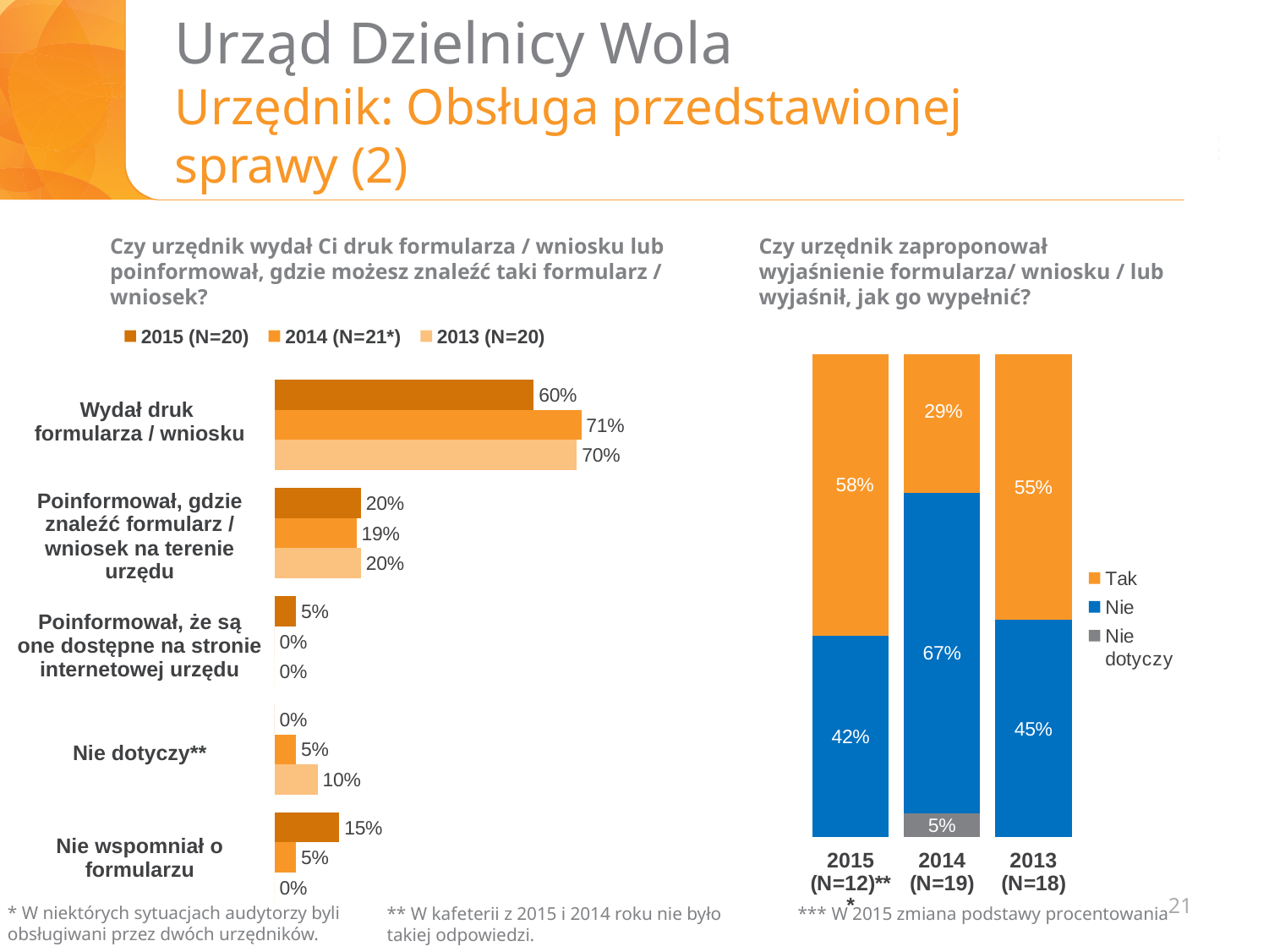
In the right chart, what is the "Nie" share for 2013 (N=18)? 45% In the left chart, what is the value for "Nie dotyczy**" in 2013 (N=20)? 10% In the left chart, what is the difference between the 2014 and 2015 values for "Wydał druk formularza / wniosku"? 11 percentage points In the left chart, which category has the highest value for 2015 (N=20)? Wydał druk formularza / wniosku In the right chart, which year has the highest "Nie" share? 2014 (N=19) In the left chart, how many categories are shown? 5 In the left chart, what is the value for "Nie wspomniał o formularzu" in 2015 (N=20)? 15% In the left chart ("Czy urzędnik wydał Ci druk formularza / wniosku..."), what is the value for "Wydał druk formularza / wniosku" in 2014 (N=21*)? 71% In the left chart, how many series does the legend list? 3 In the right chart ("Czy urzędnik zaproponował wyjaśnienie formularza..."), what is the "Tak" share for 2014 (N=19)? 29% In the right chart, is the "Tak" share for 2015 (N=12)** larger or smaller than the "Tak" share for 2013 (N=18)? Larger What type of chart is the left chart? Bar chart